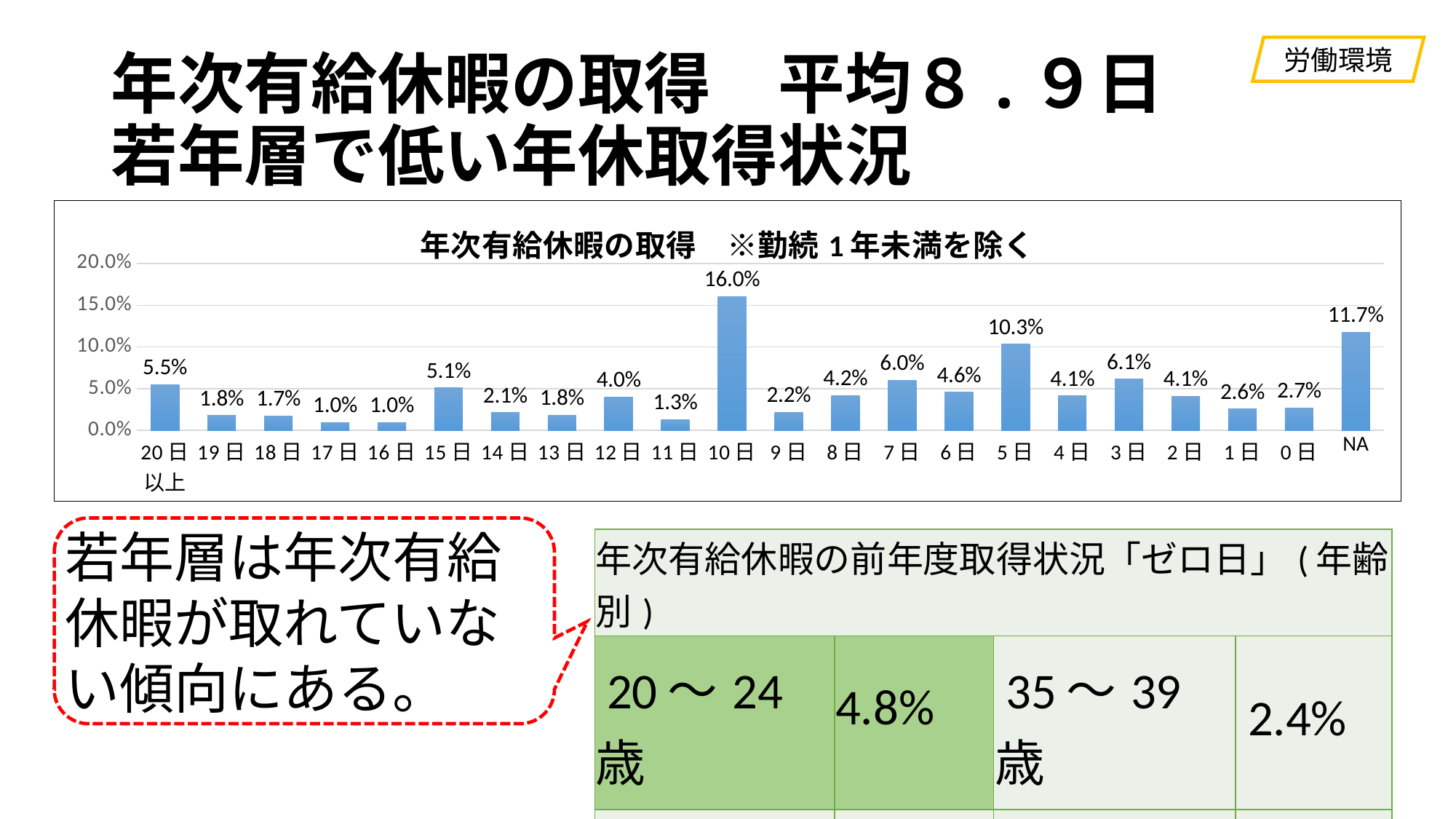
What is the difference between the values for 10日 and 5日? 5.7% What is the value for 10日 in the chart? 16.0% What is the title of the chart? 年次有給休暇の取得 ※勤続１年未満を除く Which category has the highest value in the chart? 10日 What is the value for 0日 in the chart? 2.7% What is the value for 5日 in the chart? 10.3% What is the value for 20日以上 in the chart? 5.5% Is the value for NA greater or less than 10.0%? greater What is the value for NA in the chart? 11.7% What kind of chart is shown on the slide? bar chart How many categories are shown on the x axis of the chart? 22 Which is larger, the value for 7日 or the value for 3日? 3日